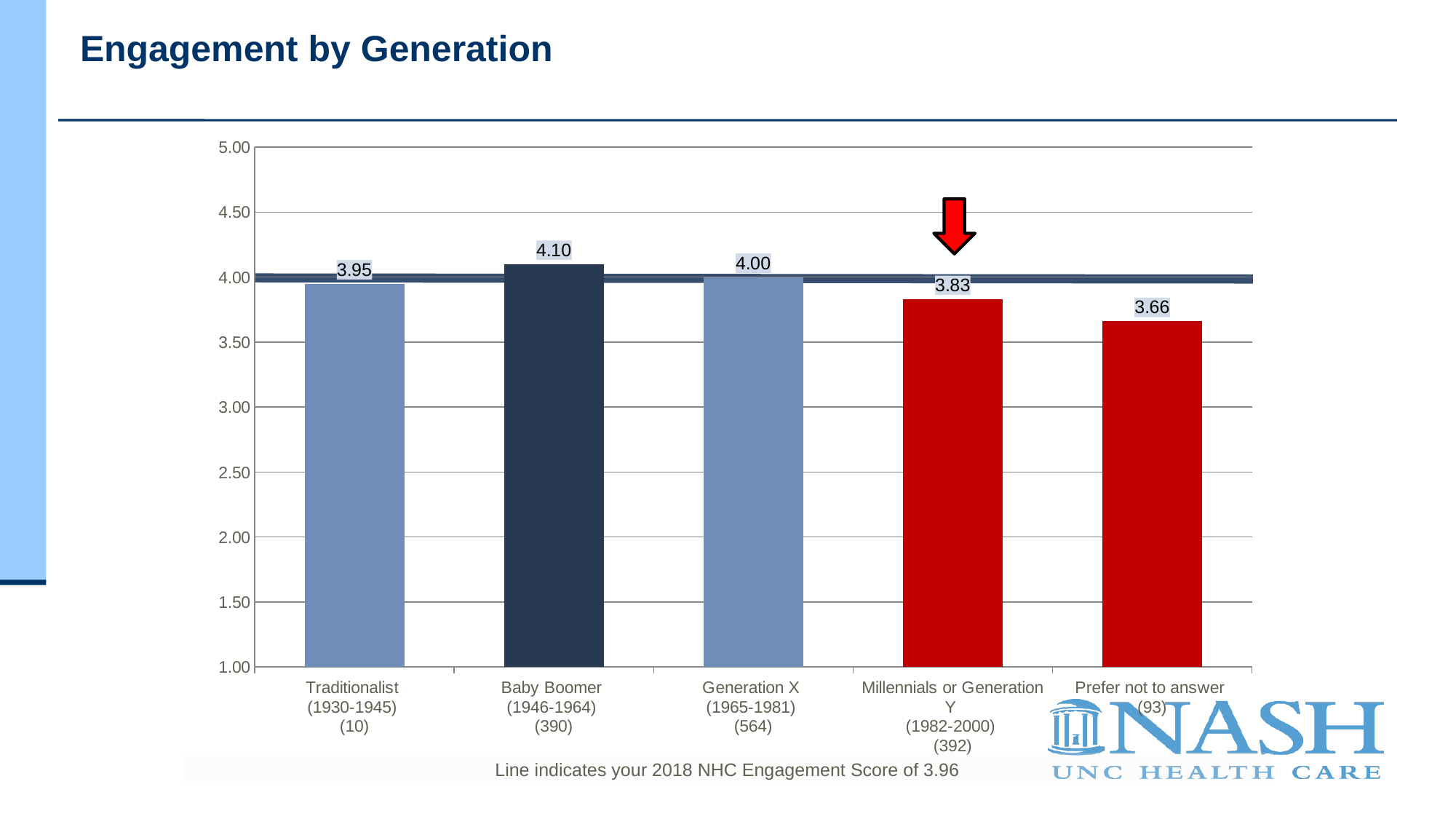
What is the engagement score for the Prefer not to answer group? 3.66 Which category has the lowest engagement score? Prefer not to answer What is the engagement score for Baby Boomer (1946-1964)? 4.10 What is the engagement score for Millennials or Generation Y (1982-2000)? 3.83 What is the difference between the Baby Boomer score and the Millennials or Generation Y score? 0.27 How many respondents are in the Generation X (1965-1981) group? 564 What kind of chart is shown on the slide? bar chart Which generation has the highest engagement score? Baby Boomer (1946-1964) Is the value for Prefer not to answer greater or less than 4.00? less Which has a higher engagement score, Traditionalist or Generation X? Generation X How many categories are shown on the chart? 5 What does the horizontal line across the chart indicate? The 2018 NHC Engagement Score of 3.96